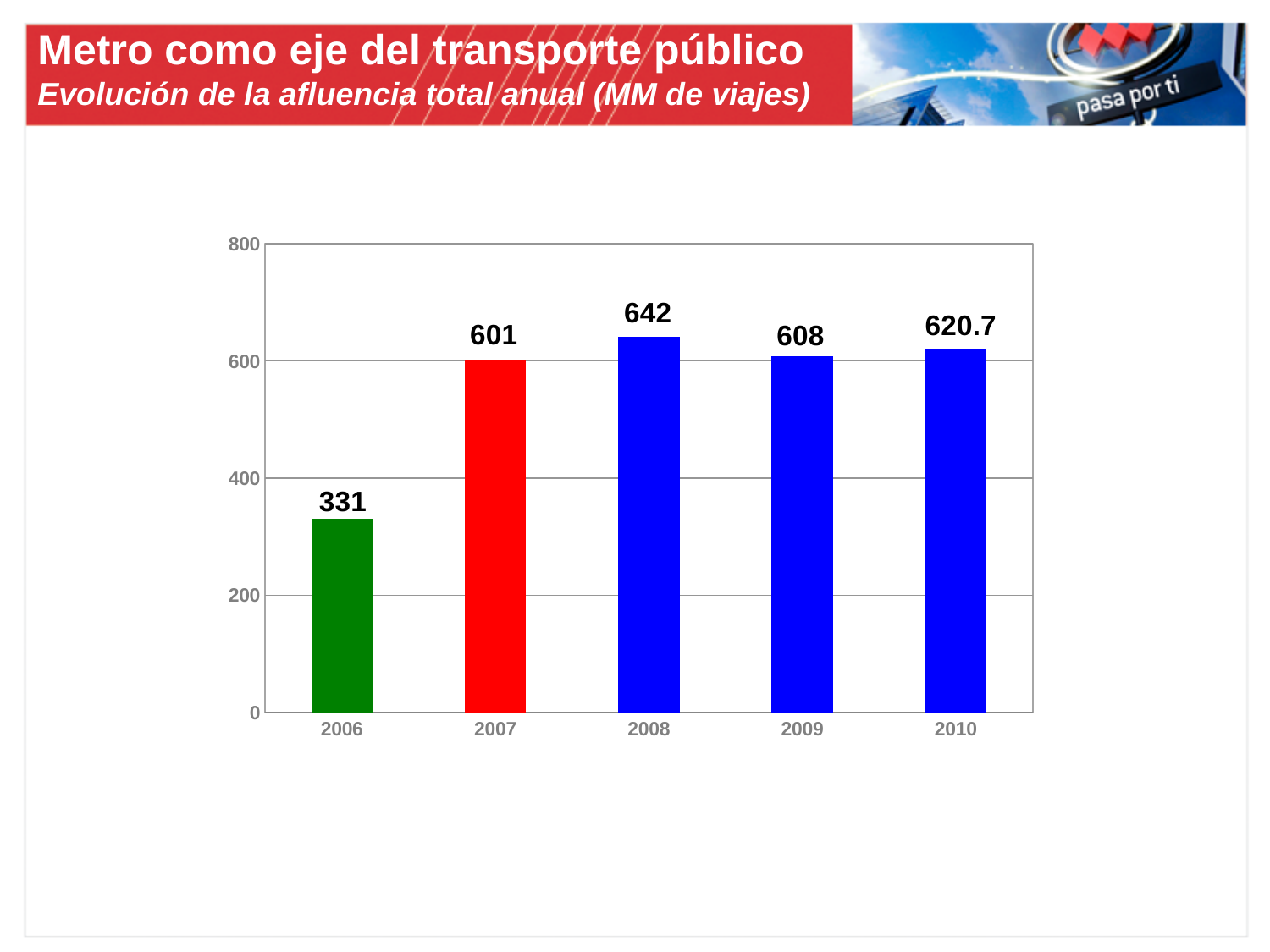
Which year has the highest value? 2008 What is the value for 2006? 331 What is the difference between the values for 2007 and 2006? 270 Which is larger, the value for 2009 or the value for 2010? 2010 What colour is the bar for 2007? red Is the value for 2006 greater or less than 400? less How many years are shown on the x axis? 5 What is the difference between the values for 2008 and 2009? 34 Which year has the lowest value? 2006 What is the value for 2008? 642 What is the value for 2010? 620.7 What kind of chart is shown on the slide? bar chart